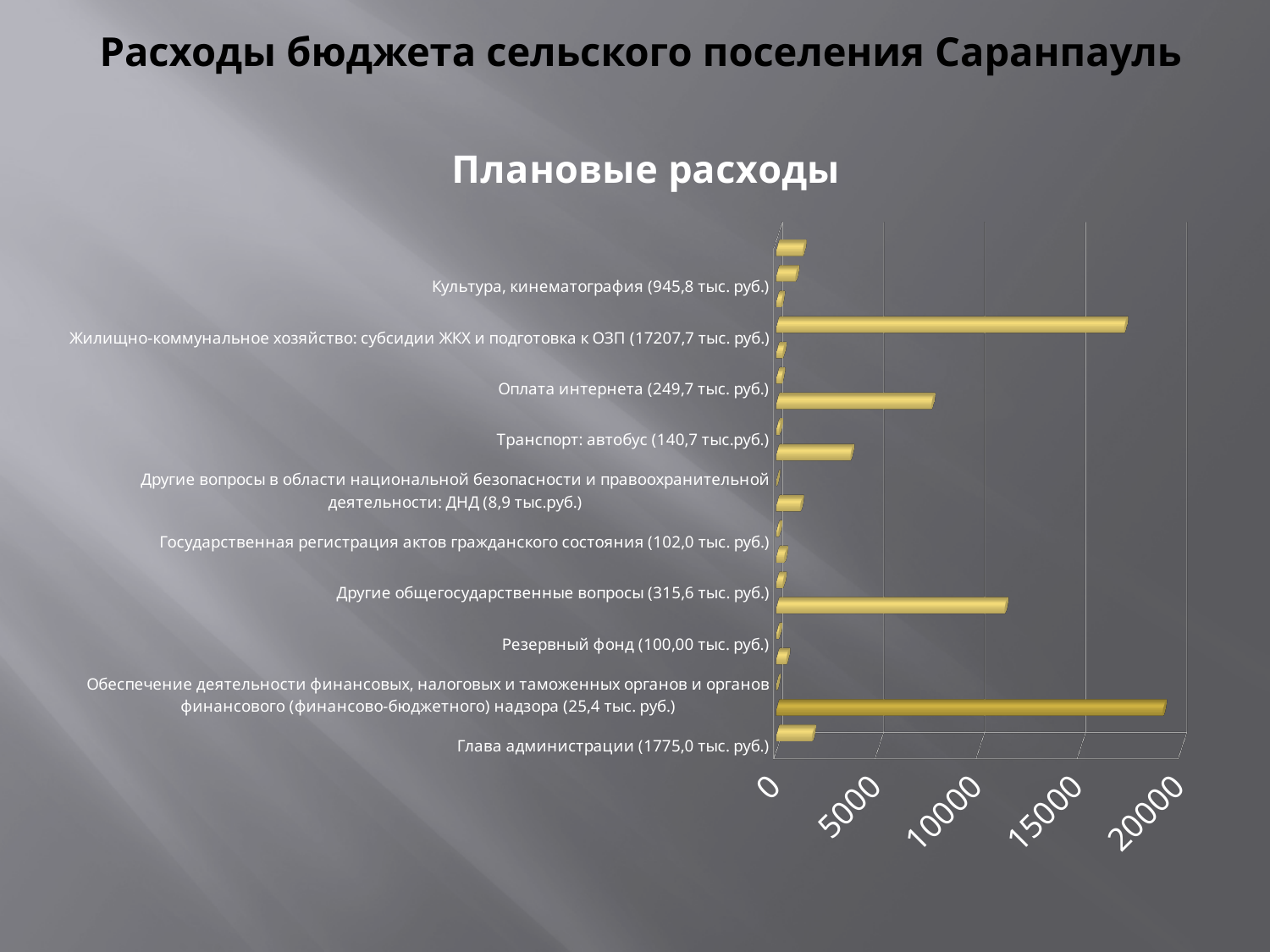
What is the title of the chart? Плановые расходы What kind of chart is shown on the slide? bar chart Which of the labelled categories has the lowest planned expenditure? Другие вопросы в области национальной безопасности и правоохранительной деятельности: ДНД Which is larger: the planned expenditure for Оплата интернета or for Другие общегосударственные вопросы? Другие общегосударственные вопросы What is the planned expenditure for Глава администрации? 1775,0 тыс. руб. What is the planned expenditure for Культура, кинематография? 945,8 тыс. руб. What is the planned expenditure for Резервный фонд? 100,00 тыс. руб. What is the difference between the planned expenditure for Глава администрации and for Культура, кинематография? 829,2 тыс. руб. Which of the labelled categories has the highest planned expenditure? Жилищно-коммунальное хозяйство: субсидии ЖКХ и подготовка к ОЗП Is the bar for Жилищно-коммунальное хозяйство: субсидии ЖКХ и подготовка к ОЗП greater or less than 15000? greater What is the planned expenditure for Жилищно-коммунальное хозяйство: субсидии ЖКХ и подготовка к ОЗП? 17207,7 тыс. руб. What is the planned expenditure for Транспорт: автобус? 140,7 тыс.руб.